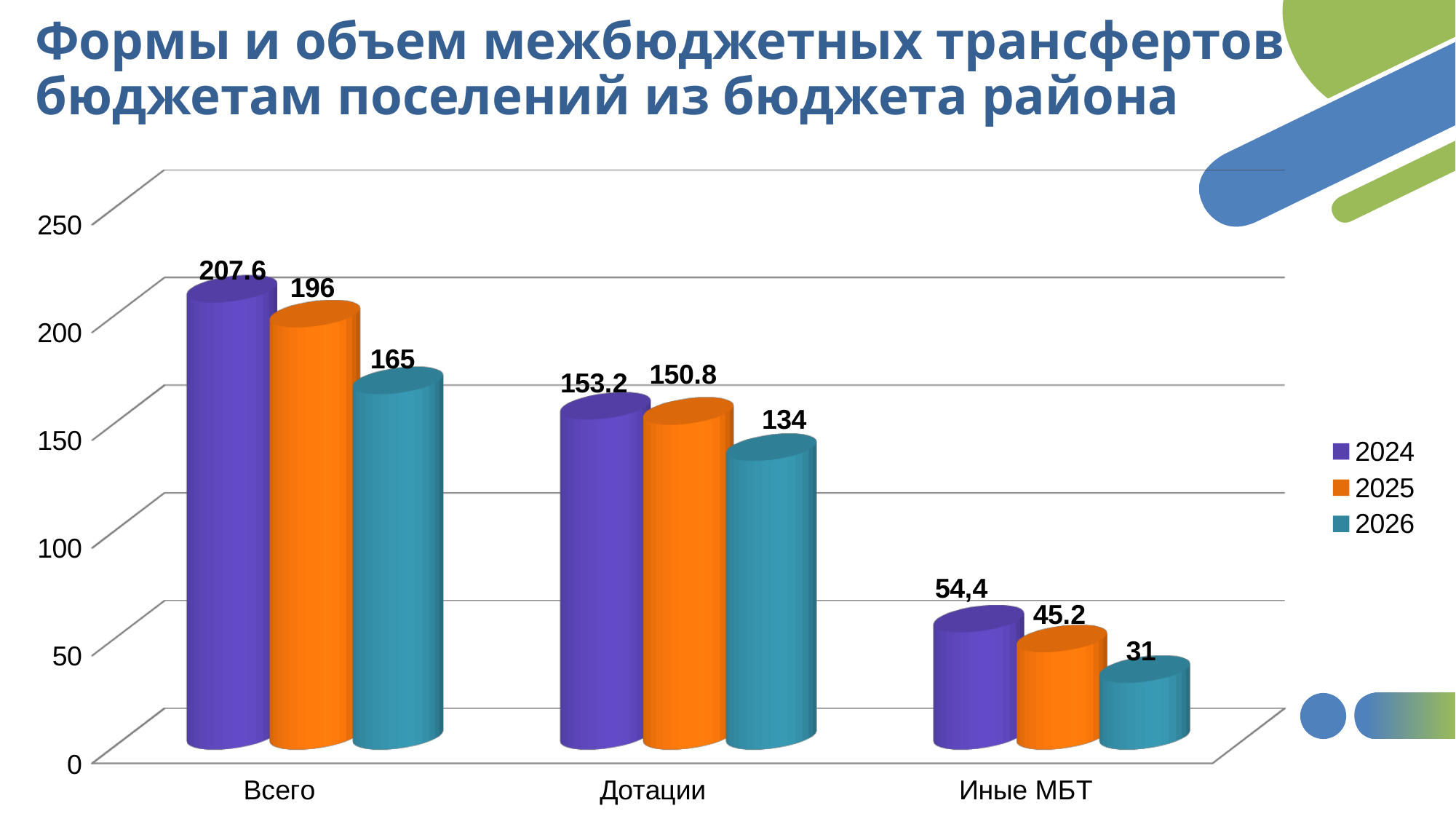
What kind of chart is shown on the slide? Bar chart Which is larger in the Дотации category: the value for 2024 or the value for 2026? 2024 What is the value for 2026 in the Дотации category? 134 Which category has the highest value for 2024? Всего What is the difference between the 2024 and 2026 values in the Всего category? 42.6 What is the value for 2024 in the Всего category? 207.6 Which category has the lowest value for 2026? Иные МБТ What is the difference between the 2025 and 2026 values in the Иные МБТ category? 14.2 What is the value for 2025 in the Иные МБТ category? 45.2 Which colour represents the 2025 series in the legend? Orange How many series does the legend list? 3 How many categories are shown on the x axis? 3